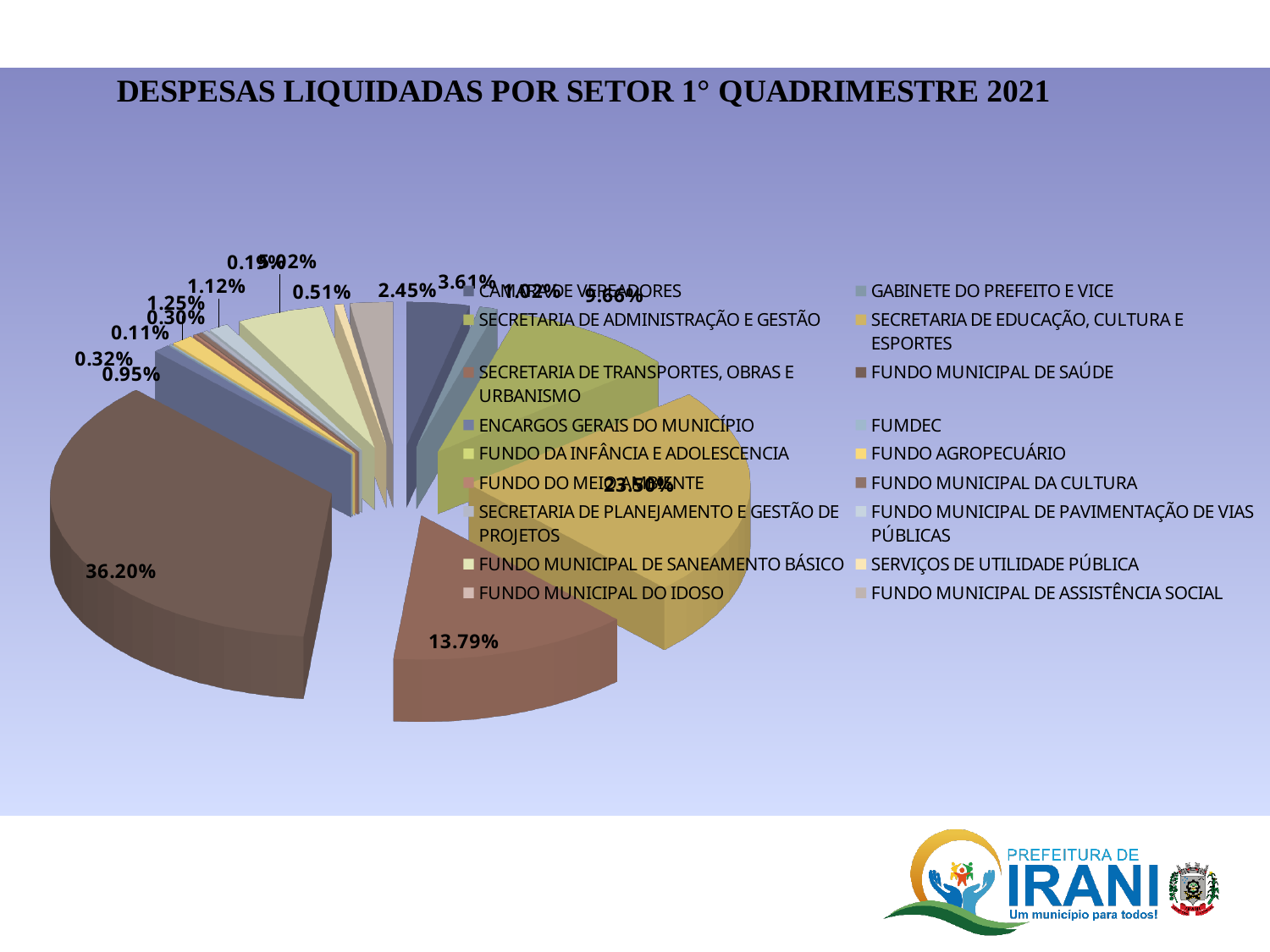
Is the largest slice of the pie greater or less than 30%? greater What is the title of the chart? DESPESAS LIQUIDADAS POR SETOR 1° QUADRIMESTRE 2021 What is the difference between the slice labeled 36.20% and the slice labeled 13.79%? 22.41% Which is larger, the slice labeled 23.50% or the slice labeled 13.79%? 23.50% What share of the pie does SECRETARIA DE EDUCAÇÃO, CULTURA E ESPORTES represent? 23.50% What is the largest percentage labeled on the pie chart? 36.20% What is the difference between the slice labeled 23.50% and the slice labeled 9.66%? 13.84% What share of the pie does the largest slice, FUNDO MUNICIPAL DE SAÚDE, represent? 36.20% What kind of chart is shown on the slide? pie chart Which is larger, the slice labeled 3.61% or the slice labeled 2.45%? 3.61% How many entries does the chart legend list? 18